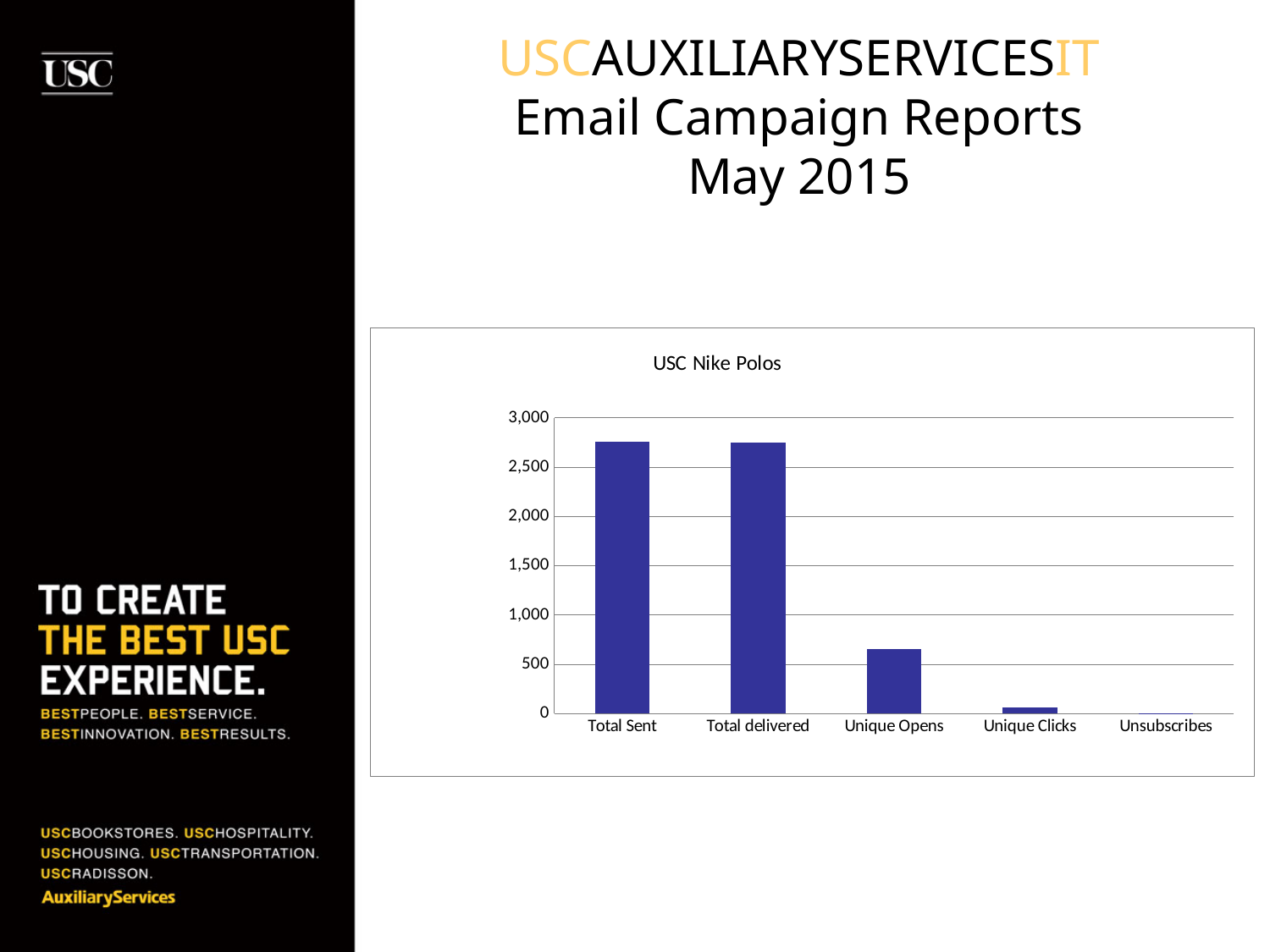
Is the value for Unique Opens greater or less than 500? greater How many categories are plotted on the x axis of the chart? 5 Is the value for Unique Clicks greater or less than 500? less Which is larger, the value for Unique Opens or the value for Unique Clicks? Unique Opens Which category has the lowest value in the chart? Unsubscribes Is the value for Unique Opens greater or less than 1,000? less Which is larger, the value for Total Sent or the value for Unique Opens? Total Sent What is the title of the chart? USC Nike Polos Do the values rise or fall moving from left to right along the x axis? fall What kind of chart is shown on the slide? bar chart